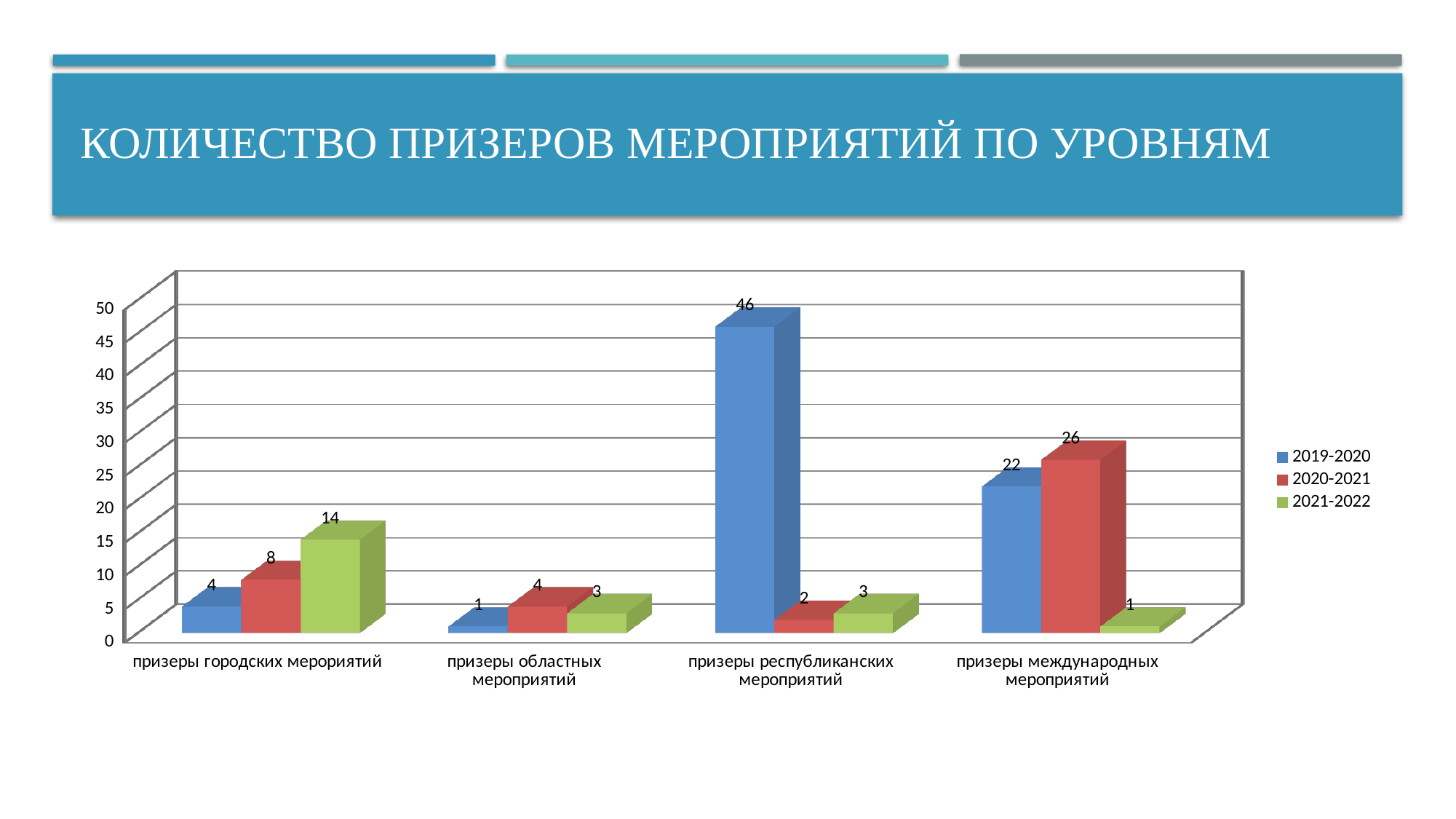
How many categories are shown on the x axis? 4 Which category has the highest value for the 2019-2020 series? призеры республиканских мероприятий Which category has the lowest value for the 2021-2022 series? призеры международных мероприятий Which is larger for 'призеры городских мероиятий': the 2020-2021 value or the 2021-2022 value? 2021-2022 Is the 2019-2020 value for 'призеры республиканских мероприятий' greater or less than 40? greater What type of chart is shown on the slide? bar chart What is the value for 2019-2020 in the category 'призеры республиканских мероприятий'? 46 What is the title of the slide? КОЛИЧЕСТВО ПРИЗЕРОВ МЕРОПРИЯТИЙ ПО УРОВНЯМ What is the value for 2020-2021 in the category 'призеры международных мероприятий'? 26 What is the value for 2021-2022 in the category 'призеры городских мероиятий'? 14 What is the difference between the 2020-2021 and 2019-2020 values for 'призеры международных мероприятий'? 4 How many series does the legend list? 3